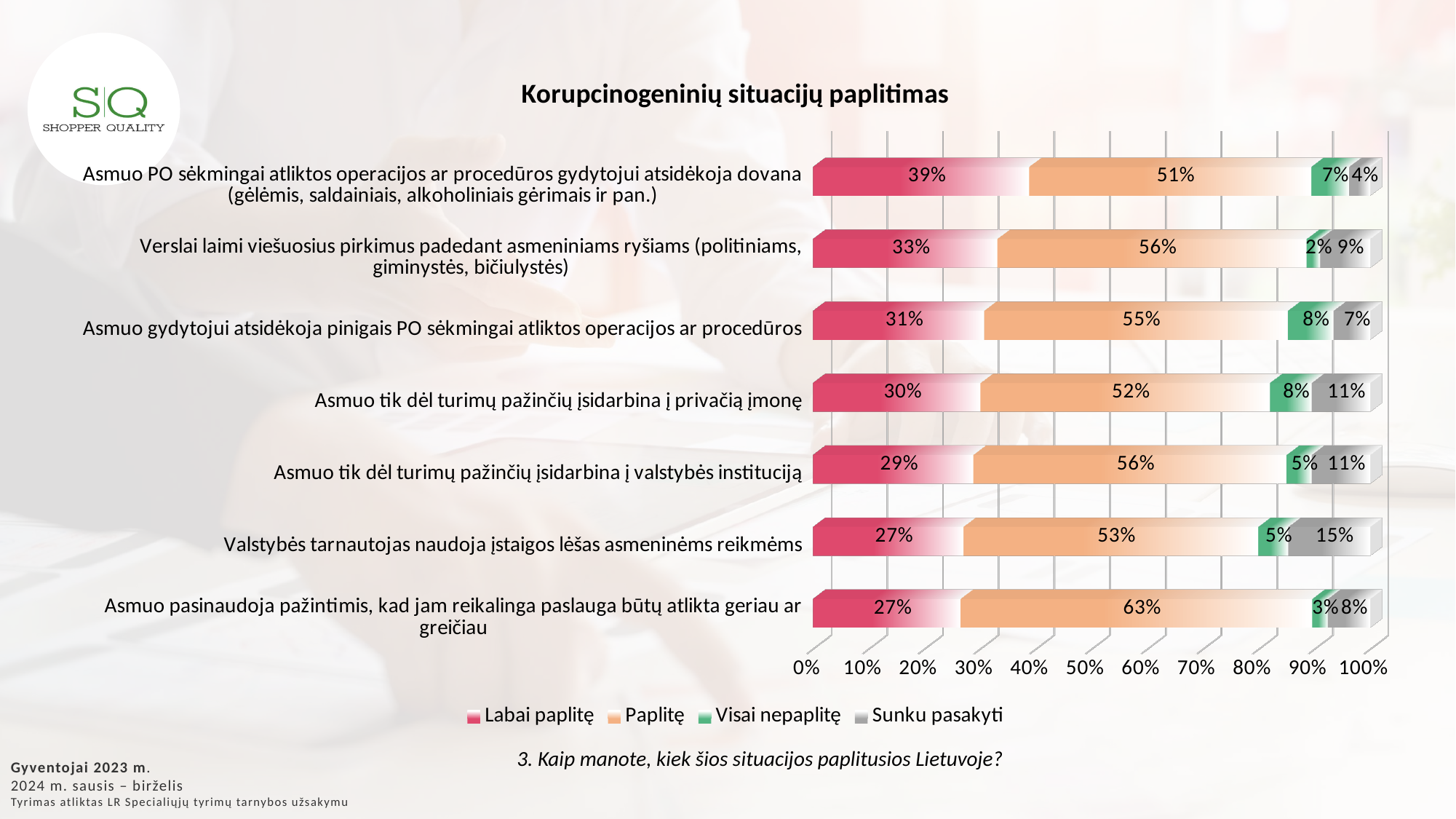
How many situations (categories) are shown in the chart? 7 What is the 'Sunku pasakyti' value for 'Valstybės tarnautojas naudoja įstaigos lėšas asmeninėms reikmėms'? 15% Which situation has the highest 'Labai paplitę' share? Asmuo PO sėkmingai atliktos operacijos ar procedūros gydytojui atsidėkoja dovana What percentage of respondents said 'Labai paplitę' for 'Asmuo PO sėkmingai atliktos operacijos ar procedūros gydytojui atsidėkoja dovana'? 39% Which has a larger 'Sunku pasakyti' share: 'Asmuo tik dėl turimų pažinčių įsidarbina į privačią įmonę' or 'Asmuo gydytojui atsidėkoja pinigais PO sėkmingai atliktos operacijos ar procedūros'? Asmuo tik dėl turimų pažinčių įsidarbina į privačią įmonę What is the total of the stacked bar for 'Valstybės tarnautojas naudoja įstaigos lėšas asmeninėms reikmėms'? 100% What is the 'Paplitę' value for 'Asmuo pasinaudoja pažintimis, kad jam reikalinga paslauga būtų atlikta geriau ar greičiau'? 63% What is the title of the chart? Korupcinogeninių situacijų paplitimas What kind of chart is shown on the slide? Stacked bar chart What is the difference between the 'Paplitę' values for 'Asmuo pasinaudoja pažintimis...' (63%) and 'Asmuo PO sėkmingai atliktos operacijos... atsidėkoja dovana' (51%)? 12% Which situation has the lowest 'Visai nepaplitę' share? Verslai laimi viešuosius pirkimus padedant asmeniniams ryšiams How many series does the legend list? 4